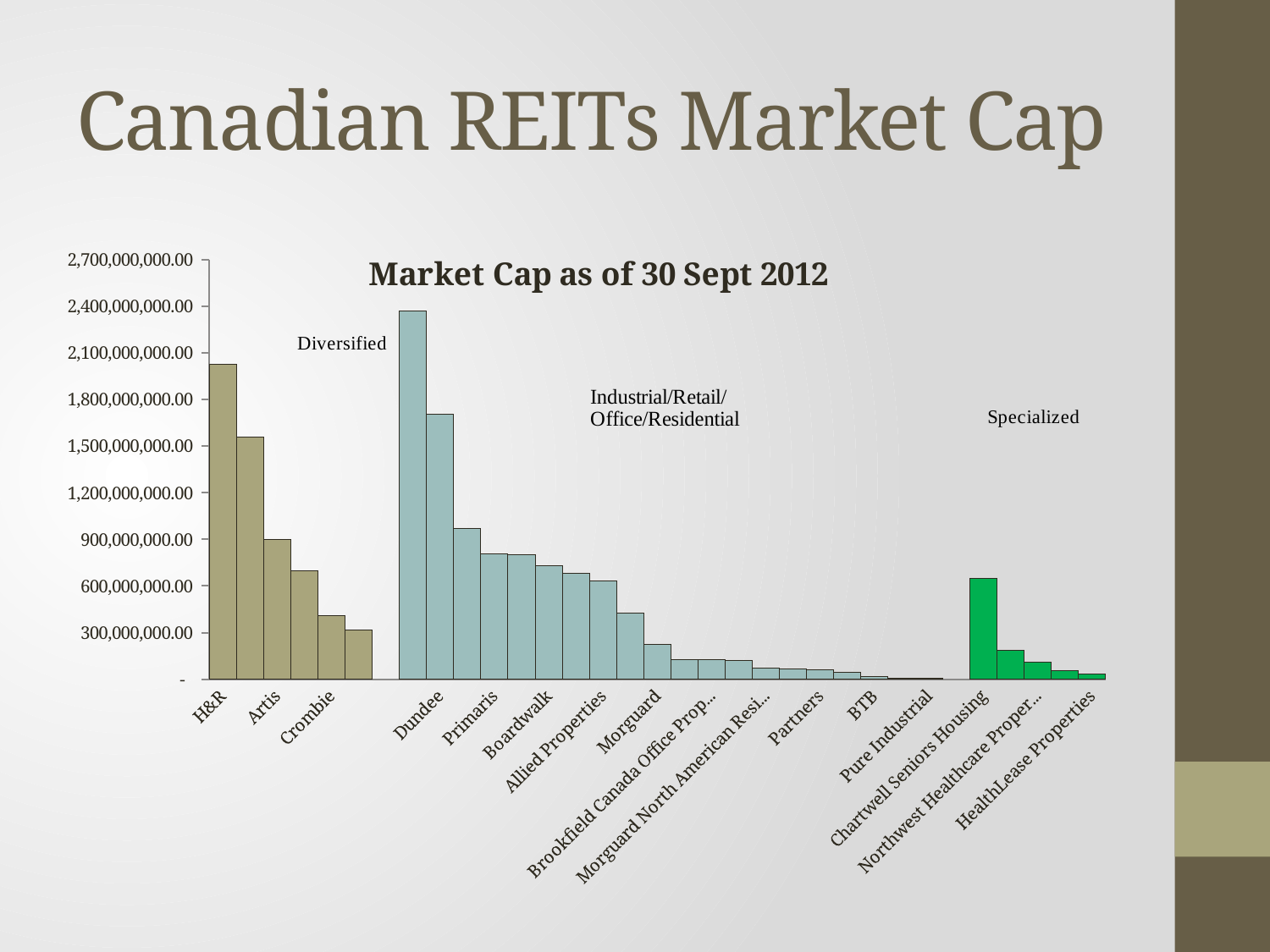
Is the market cap for Chartwell Seniors Housing greater or less than 900,000,000.00? less Is the market cap for H&R greater or less than 1,800,000,000.00? greater Is the market cap for Primaris greater or less than 1,200,000,000.00? less Within the Diversified group, do the bars rise or fall from left to right? fall Which has the larger market cap, Chartwell Seniors Housing or H&R? H&R What are the three group labels written above the bars in the chart? Diversified, Industrial/Retail/Office/Residential, Specialized What is the title of the chart? Market Cap as of 30 Sept 2012 Which has the larger market cap, H&R or Dundee? H&R What kind of chart is shown on the slide? bar chart